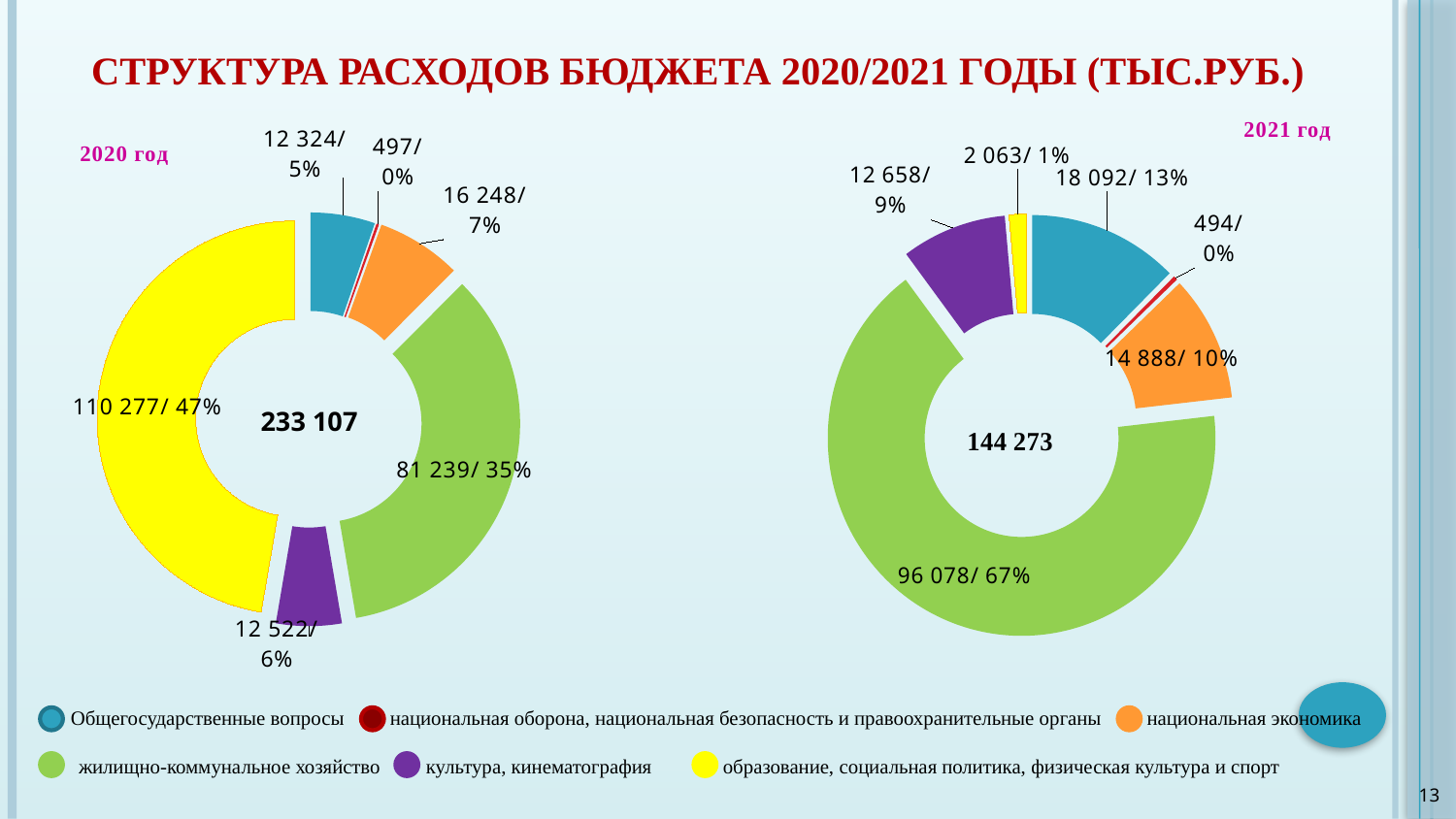
On the 2021 год chart, which is larger: национальная экономика or культура, кинематография? национальная экономика On the 2021 год chart, which category has the smallest value? национальная оборона, национальная безопасность и правоохранительные органы Which colour represents культура, кинематография in the legend? Purple How many categories does the legend list? 6 On the 2020 год chart, what is the difference between the values for национальная экономика and Общегосударственные вопросы? 3 924 What type of chart is used for the 2020 год and 2021 год data? Doughnut (pie) chart On the 2021 год chart, what share of the total does жилищно-коммунальное хозяйство account for? 67% What total is shown in the centre of the 2021 год chart? 144 273 On the 2021 год chart, what value is shown for Общегосударственные вопросы? 18 092/ 13% What total is shown in the centre of the 2020 год chart? 233 107 On the 2020 год chart, what value is shown for жилищно-коммунальное хозяйство? 81 239/ 35% On the 2020 год chart, which category has the largest share? образование, социальная политика, физическая культура и спорт